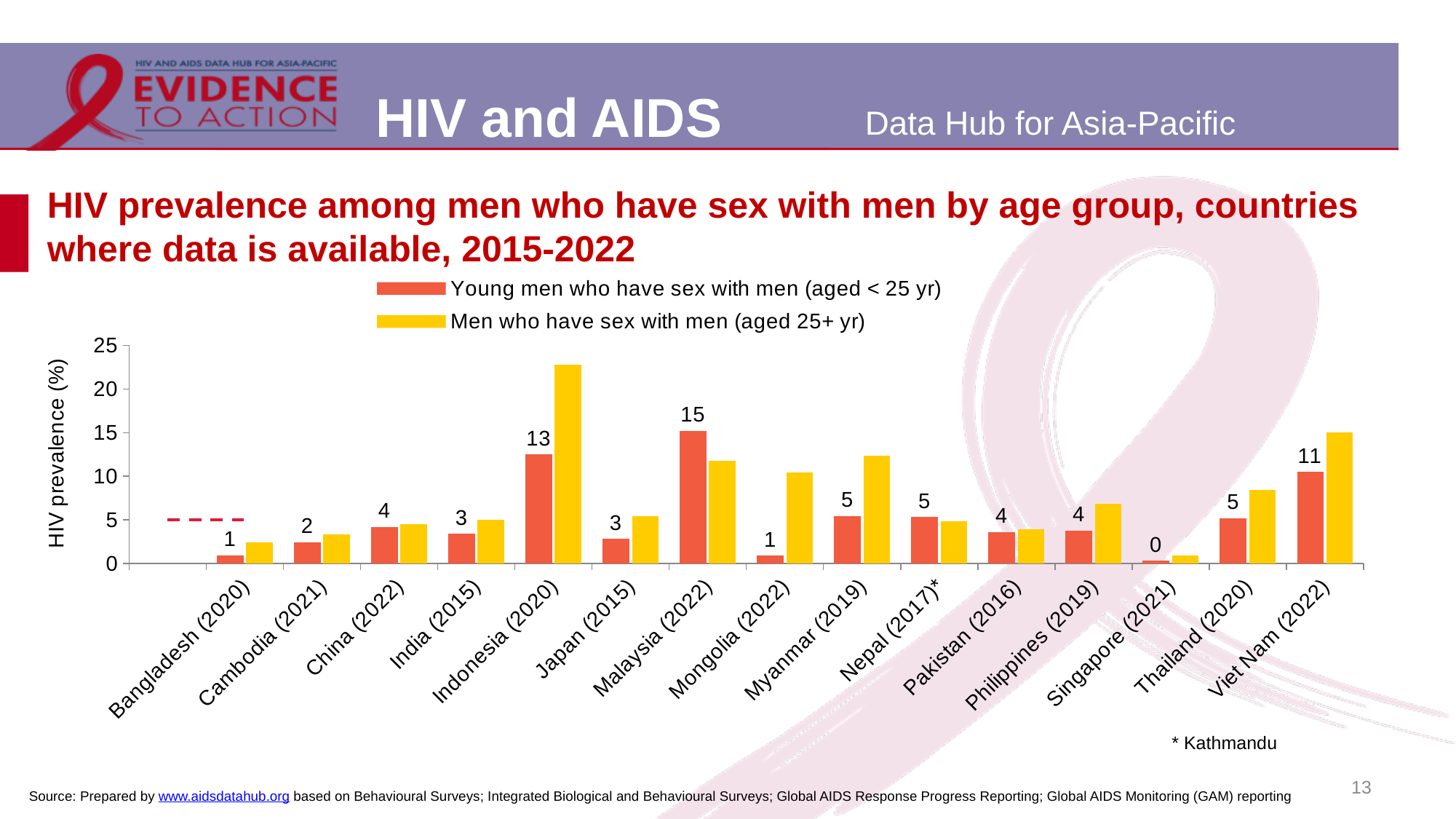
What is the HIV prevalence among young men who have sex with men (aged < 25 yr) in Malaysia (2022)? 15 Which country has the highest HIV prevalence among young men who have sex with men (aged < 25 yr)? Malaysia (2022) What kind of chart is shown on the slide? Bar chart What is the difference between the HIV prevalence among young men who have sex with men in Malaysia (2022) and in Indonesia (2020)? 2 Which country has the lowest HIV prevalence among young men who have sex with men (aged < 25 yr)? Singapore (2021) Is the HIV prevalence among men who have sex with men (aged 25+ yr) in Indonesia (2020) greater or less than 20? greater Which is larger: the HIV prevalence among young men who have sex with men in Viet Nam (2022) or in Thailand (2020)? Viet Nam (2022) What is the HIV prevalence among young men who have sex with men (aged < 25 yr) in Indonesia (2020)? 13 How many series does the legend list? 2 Is the HIV prevalence among men who have sex with men (aged 25+ yr) in Singapore (2021) greater or less than 5? less What is the HIV prevalence among young men who have sex with men (aged < 25 yr) in Viet Nam (2022)? 11 How many countries are shown on the x axis of the chart? 15